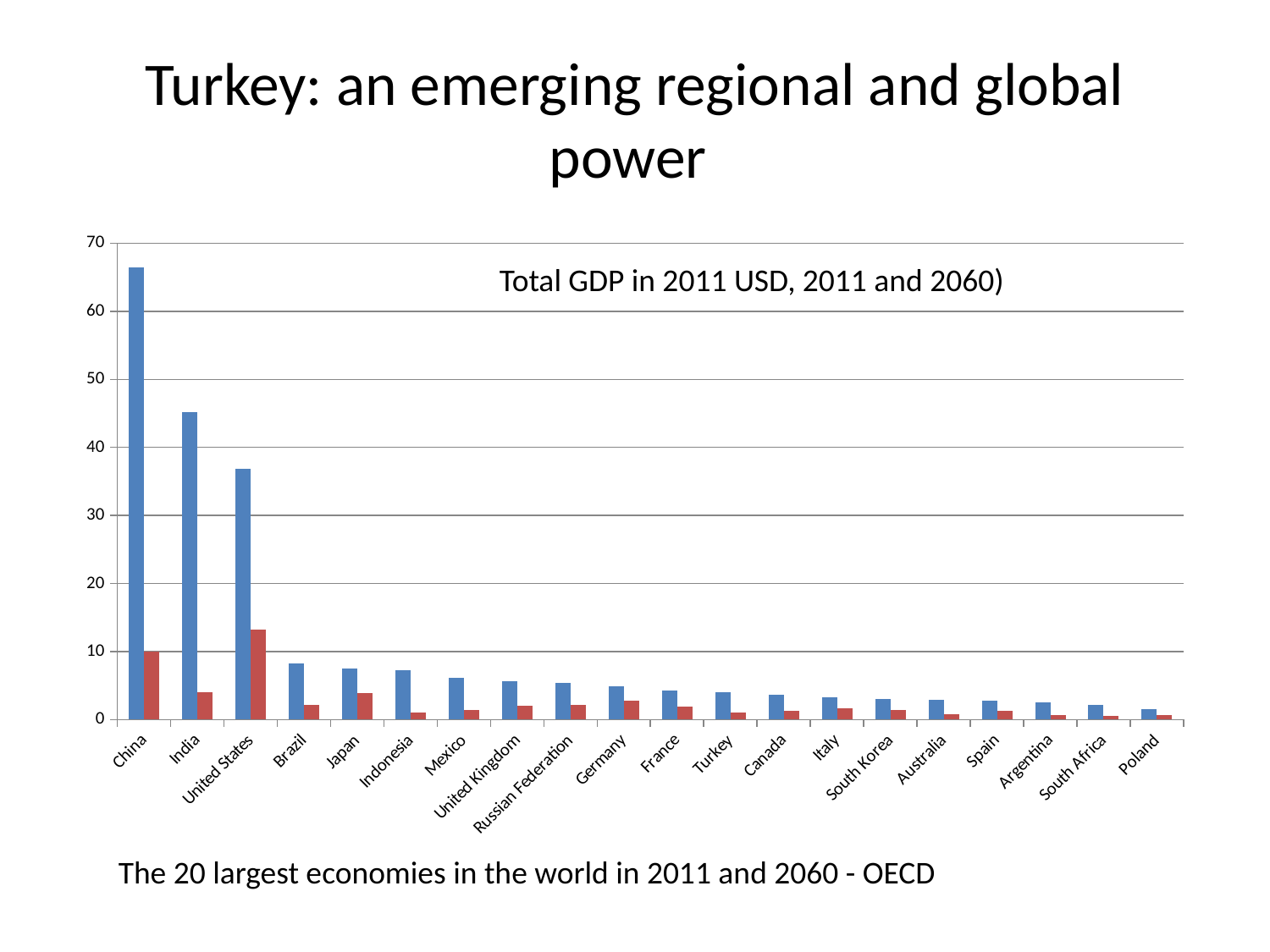
What kind of chart is shown on the slide? bar chart Is the blue bar for India greater or less than 40? greater Which country has the shortest blue bar? Poland Is the blue bar for China greater or less than 60? greater Do the blue bars generally rise or fall from left to right across the x axis? fall Is the blue bar for United States greater or less than 40? less Which is larger, the blue bar for Brazil or the blue bar for Germany? Brazil How many countries are shown on the x axis of the chart? 20 Which country has the tallest blue bar? China Which country has the tallest red bar? United States Which is larger, the red bar for United States or the red bar for China? United States